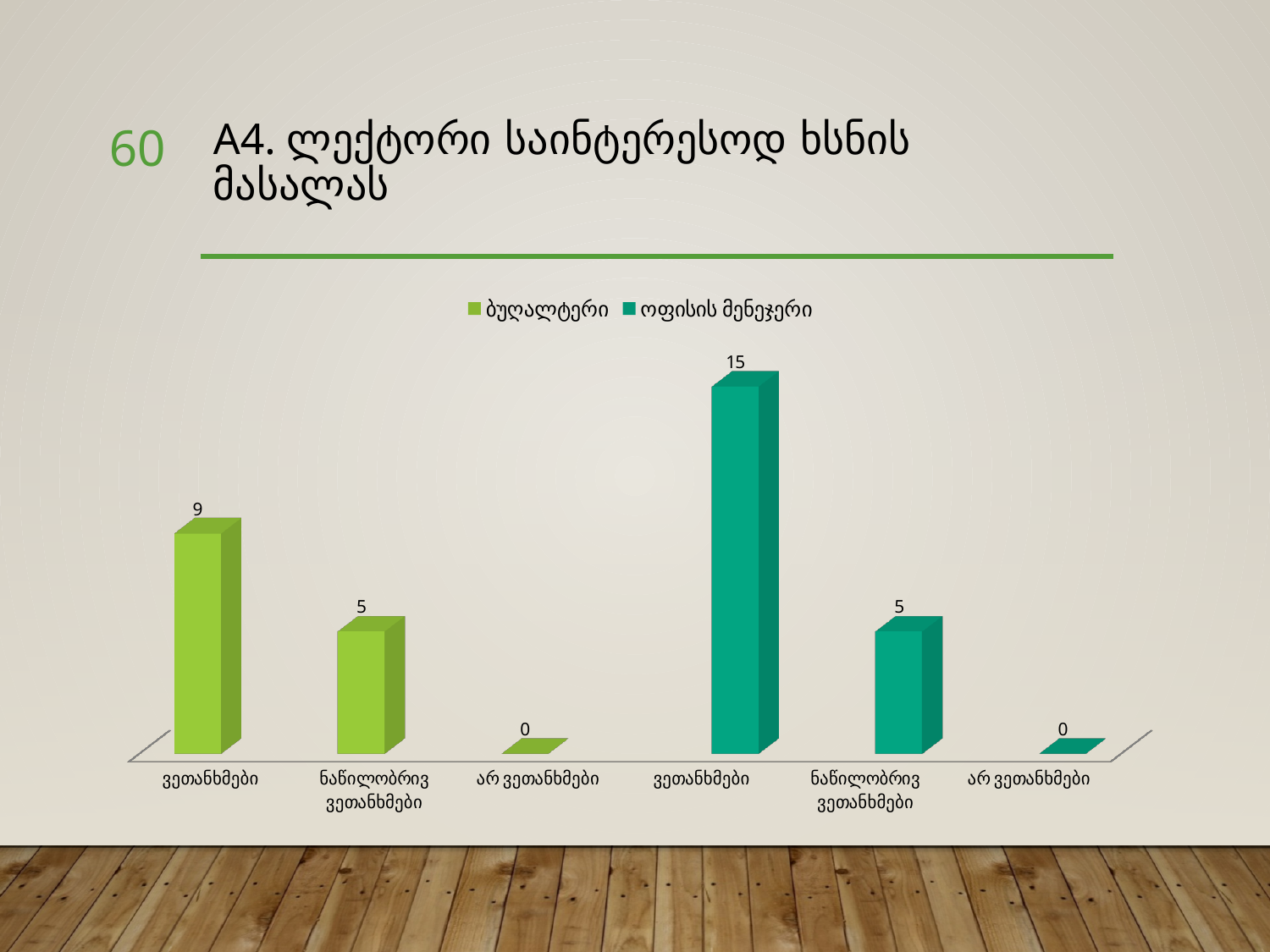
Which is larger: the ვეთანხმები value for ბუღალტერი or for ოფისის მენეჯერი? ოფისის მენეჯერი What is the title of the chart on the slide? A4. ლექტორი საინტერესოდ ხსნის მასალას What is the difference between ვეთანხმები and ნაწილობრივ ვეთანხმები in the ბუღალტერი series? 4 How many bars are plotted on the chart? 6 What kind of chart is shown on the slide? Bar chart What is the value for ვეთანხმები in the ბუღალტერი series? 9 What is the value for ნაწილობრივ ვეთანხმები in the ბუღალტერი series? 5 What is the value for არ ვეთანხმები in the ოფისის მენეჯერი series? 0 What is the difference between the ვეთანხმები values for ოფისის მენეჯერი and ბუღალტერი? 6 What is the value for ვეთანხმები in the ოფისის მენეჯერი series? 15 Which bar has the highest value on the chart? ვეთანხმები (ოფისის მენეჯერი) How many series does the legend list? 2